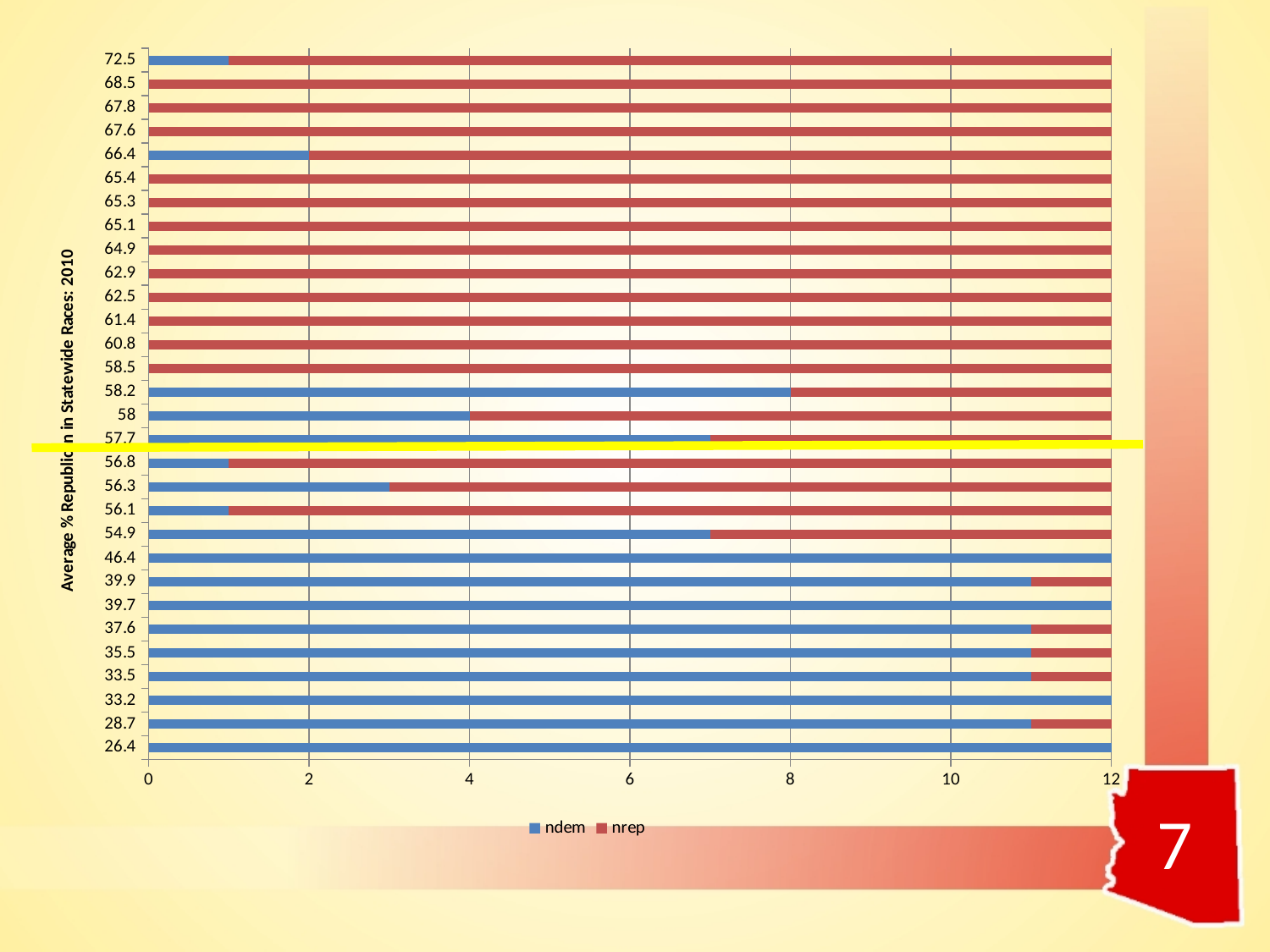
Is the ndem value for the 57.7 category greater or less than 6? greater What kind of chart is shown on the slide? bar chart What is the difference between the ndem values for the 58.2 and 58 categories? 4 What is the ndem value for the 58.2 category? 8 How many series does the legend list? 2 What are the two series named in the legend? ndem and nrep Is the ndem value for the 72.5 category greater or less than 2? less What is the ndem value for the 58 category? 4 What is the ndem value for the 66.4 category? 2 How many categories are plotted on the vertical axis? 30 What is the ndem value for the 26.4 category? 12 Which has the larger ndem value, the 58.2 category or the 58 category? 58.2